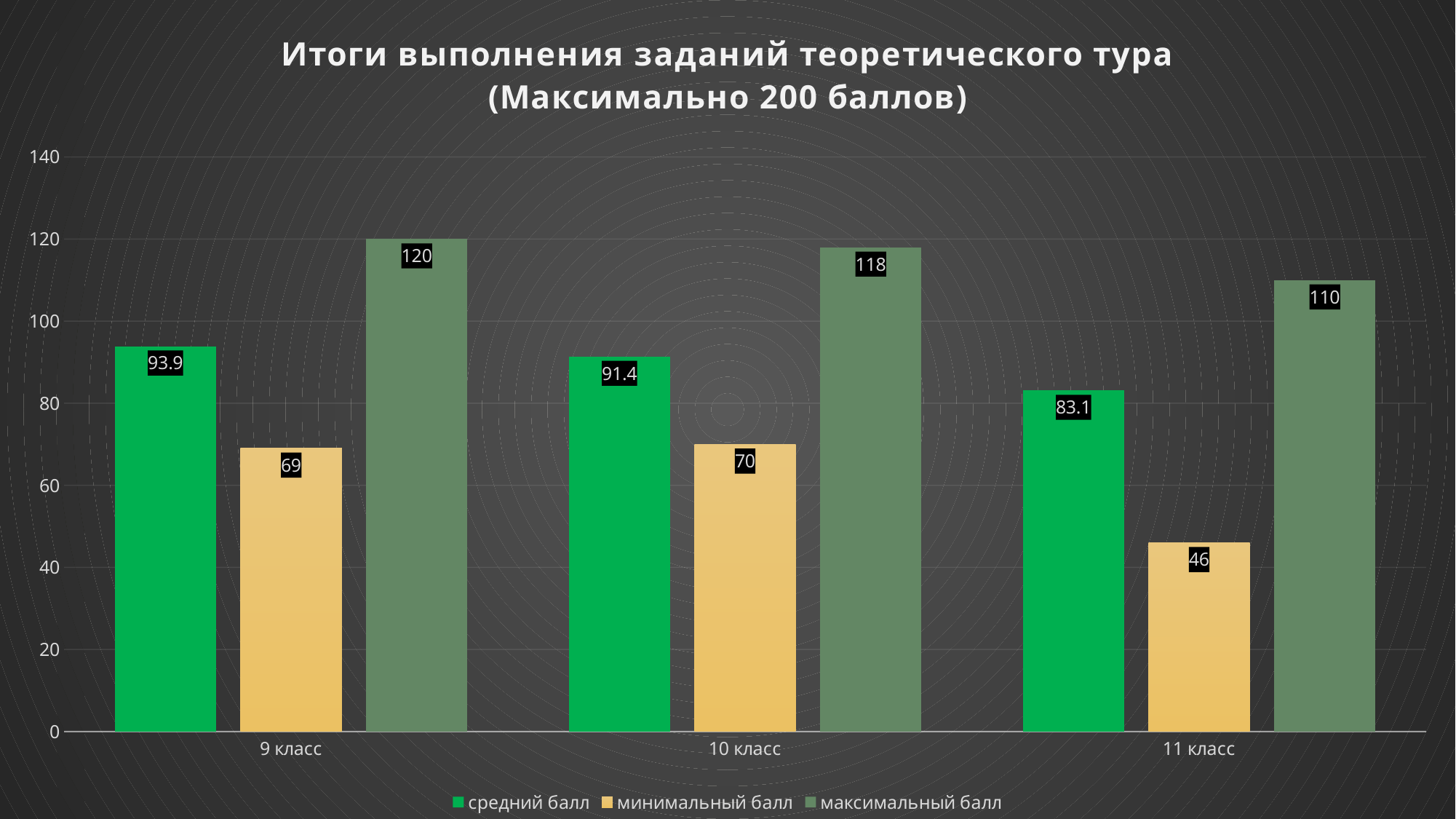
What is the минимальный балл for 11 класс? 46 What is the средний балл for 9 класс? 93.9 Which is larger: the средний балл for 10 класс or the средний балл for 11 класс? 10 класс Does the средний балл rise or fall from 9 класс to 11 класс? fall What kind of chart is shown on the slide? bar chart What is the difference between the максимальный балл and the минимальный балл for 11 класс? 64 How many classes are shown on the x axis? 3 What is the максимальный балл for 10 класс? 118 Which class has the lowest минимальный балл? 11 класс Which class has the highest максимальный балл? 9 класс How many series does the legend list? 3 Is the максимальный балл for 11 класс greater or less than 100? greater